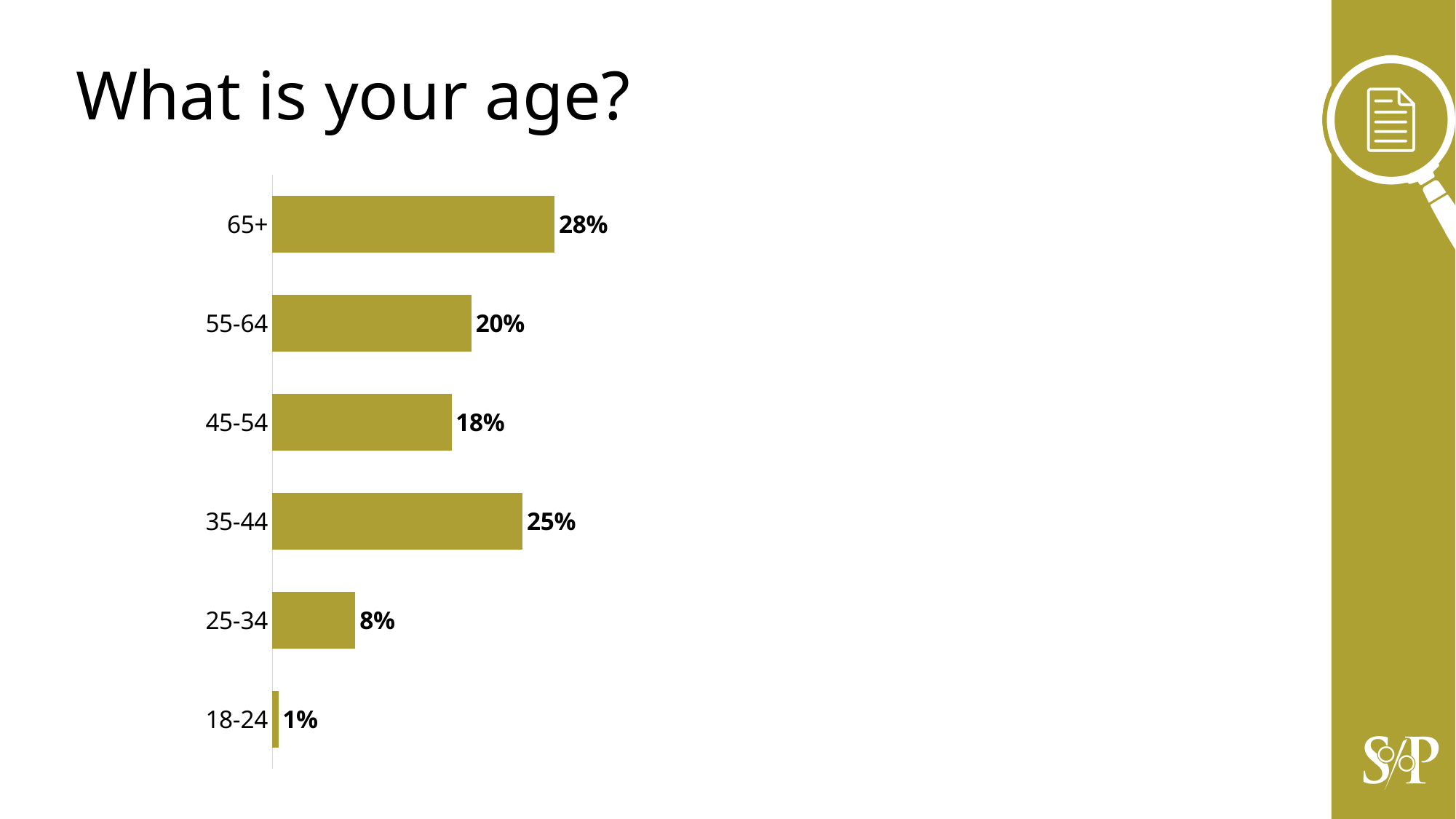
Which age group has the highest value? 65+ Which is larger, the value for 55-64 or the value for 45-54? 55-64 Which age group has the lowest value? 18-24 What is the value for the 35-44 age group? 25% What is the value for the 45-54 age group? 18% What is the difference between the values for 65+ and 55-64? 8% What is the value for the 25-34 age group? 8% What kind of chart is shown on the slide? Bar chart What is the title of the slide? What is your age? How many age groups are shown in the chart? 6 What is the difference between the values for 35-44 and 25-34? 17% What percentage of respondents are aged 65+? 28%